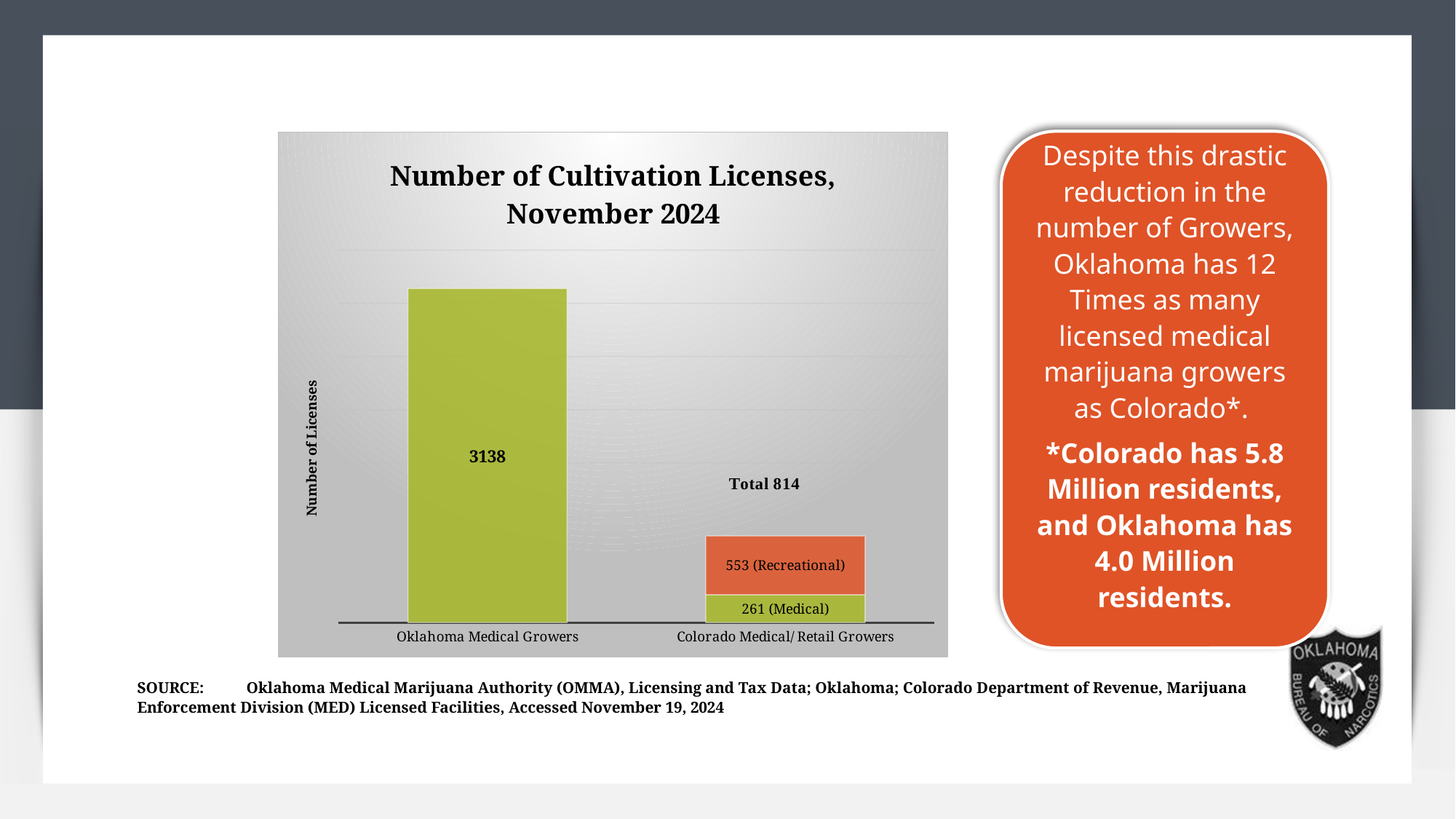
What is the label on the vertical axis of the chart? Number of Licenses Which category has the higher number of cultivation licenses? Oklahoma Medical Growers What is the title of the chart? Number of Cultivation Licenses, November 2024 How many cultivation licenses does the chart show for Oklahoma Medical Growers? 3138 How many categories are shown on the x axis of the chart? 2 How many recreational cultivation licenses does the chart show for Colorado Medical/ Retail Growers? 553 What is the difference between Colorado's recreational and medical cultivation licenses? 292 What is the difference between the number of licenses for Oklahoma Medical Growers and the total for Colorado Medical/ Retail Growers? 2324 How many medical cultivation licenses does the chart show for Colorado Medical/ Retail Growers? 261 Which category has the lower total number of cultivation licenses? Colorado Medical/ Retail Growers What is the total number of cultivation licenses for Colorado Medical/ Retail Growers? 814 What kind of chart is shown on the slide? Bar chart